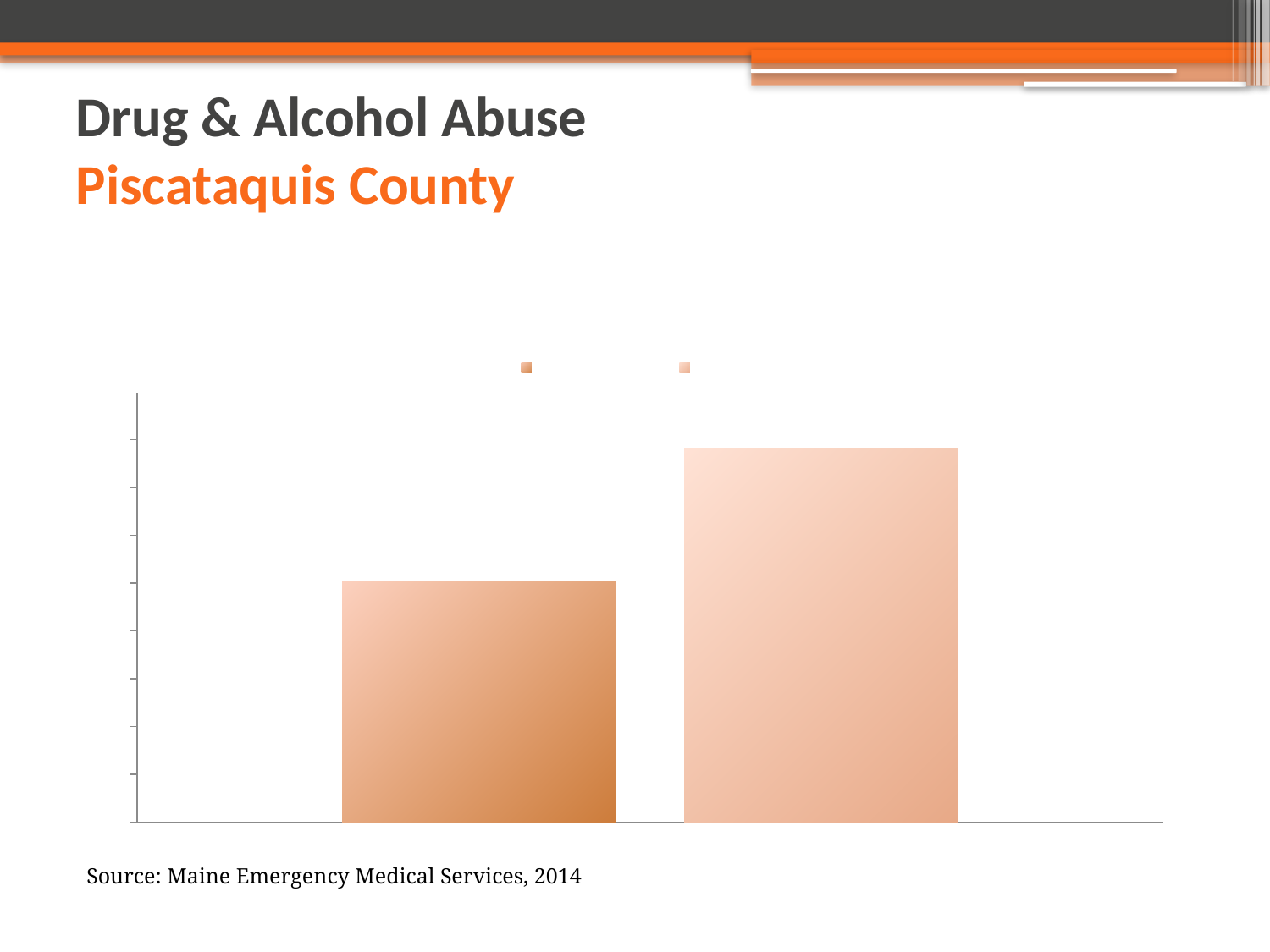
What source is cited below the chart? Maine Emergency Medical Services, 2014 Which bar is taller, the left bar or the right bar? the right bar How many bars are plotted in the chart? 2 Which county does the slide title say the chart is about? Piscataquis County What kind of chart is shown on the slide? bar chart Which bar is the shortest in the chart? the left bar How many entries does the chart's legend show? 2 Which bar is the tallest in the chart? the right bar Do the bar values rise or fall from left to right across the chart? rise